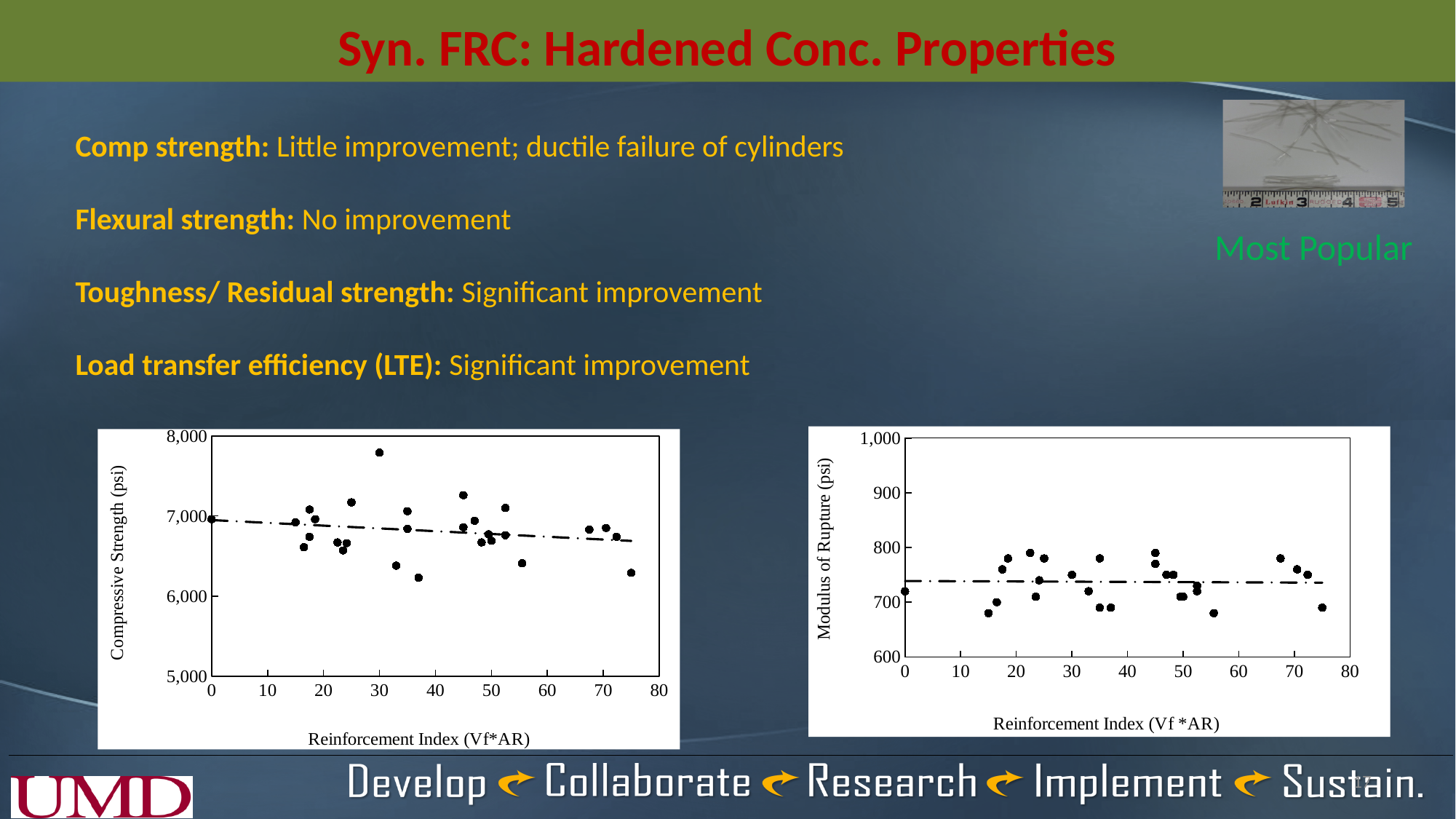
On the left chart, is the point plotted at a reinforcement index of about 75 greater or less than 7,000? less What kind of chart is the right chart (Modulus of Rupture)? scatter chart On the right chart, is the point plotted at a reinforcement index of about 75 greater or less than 700? less On the left chart, does the dashed trend line rise or fall as the reinforcement index increases? falls slightly On the left chart, is the highest plotted compressive strength value greater or less than 7,000? greater On the left chart, what is the label of the y axis? Compressive Strength (psi) On the right chart, what is the label of the y axis? Modulus of Rupture (psi) What kind of chart is the left chart (Compressive Strength)? scatter chart